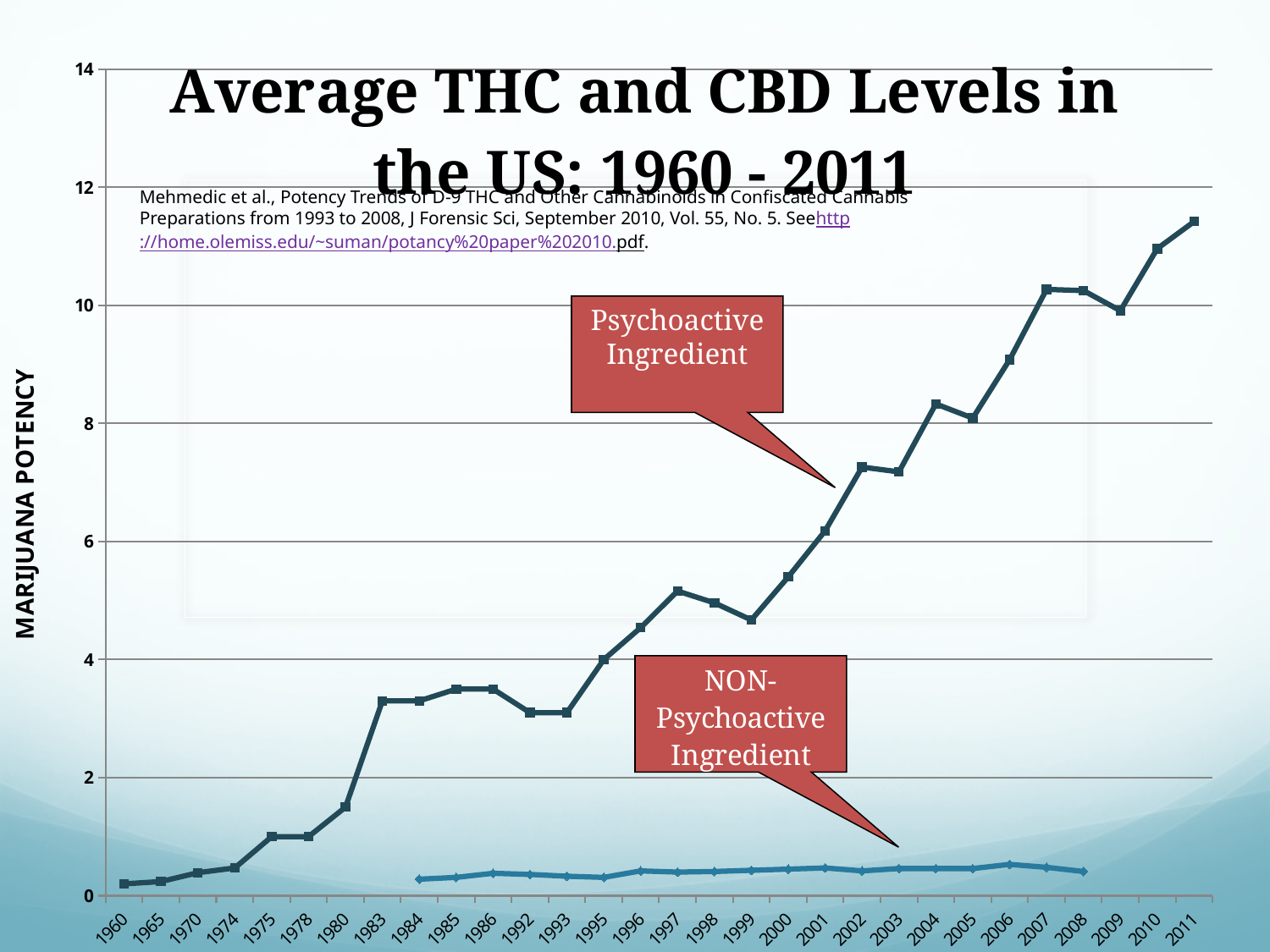
What kind of chart is shown on the slide? line chart Is the Psychoactive Ingredient value for 2011 greater or less than 10? greater Is the Psychoactive Ingredient value for 2000 greater or less than 6? less In which year is the Psychoactive Ingredient value lowest? 1960 In which year is the Psychoactive Ingredient value highest? 2011 How many years are labelled along the x axis? 30 In 2008, which line has the larger value, Psychoactive Ingredient or NON-Psychoactive Ingredient? Psychoactive Ingredient Is the NON-Psychoactive Ingredient value for 2008 greater or less than 2? less What is the title of the chart? Average THC and CBD Levels in the US: 1960 - 2011 Does the Psychoactive Ingredient line generally rise or fall from 1960 to 2011? rise What is the label on the vertical axis? MARIJUANA POTENCY